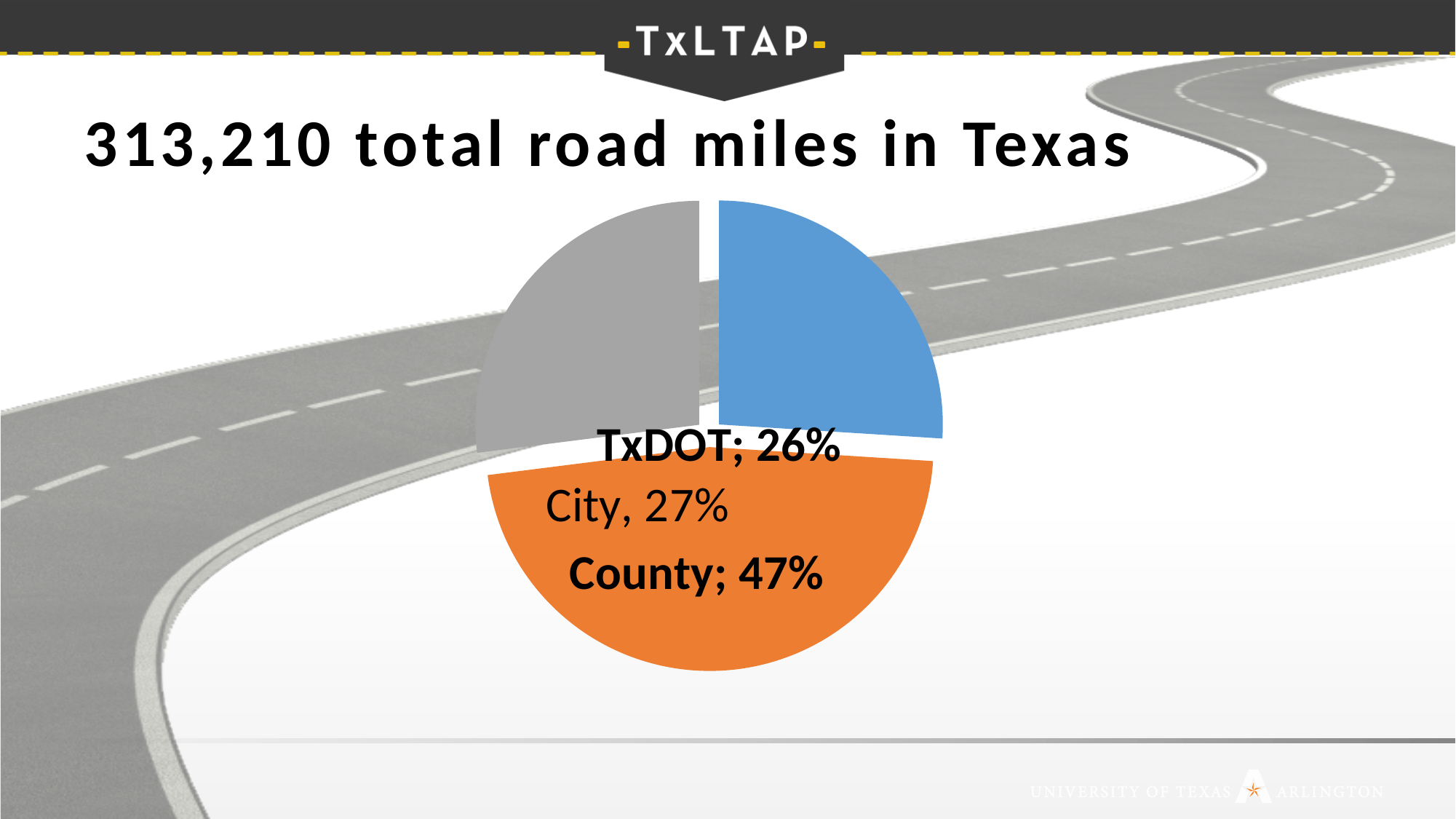
Which is larger, the County share or the City share? County By how many percentage points does the County share exceed the TxDOT share? 21 percentage points What kind of chart is shown on the slide? Pie chart How many slices does the pie chart have? 3 What share of Texas road miles does the pie chart show for City? 27% Which category has the largest slice of the pie chart? County What is the title shown above the chart? 313,210 total road miles in Texas What colour is the County slice of the pie chart? Orange Which category has the smallest slice of the pie chart? TxDOT By how many percentage points does the County share exceed the City share? 20 percentage points What share of Texas road miles does the pie chart show for County? 47% What share of Texas road miles does the pie chart show for TxDOT? 26%